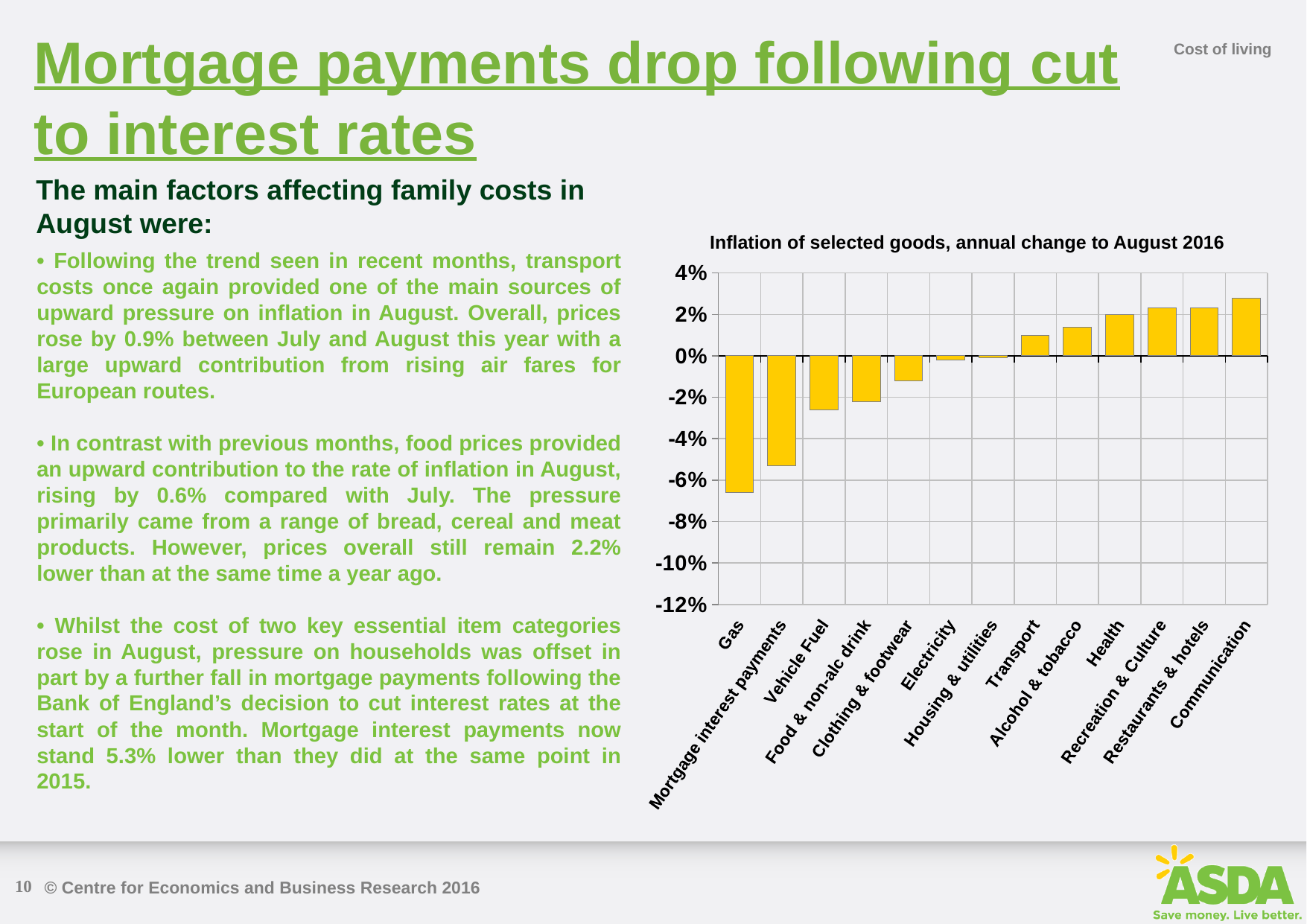
How many categories are plotted in the chart? 13 Is the value for Vehicle Fuel greater or less than -2%? less What kind of chart is shown on the slide? bar chart Which category has the highest value in the chart? Communication Is the value for Alcohol & tobacco greater or less than 2%? less Which category has the lowest value in the chart? Gas Is the value for Gas greater or less than -6%? less Do the values rise or fall moving from left to right along the x axis? rise What is the title of the chart? Inflation of selected goods, annual change to August 2016 Which has the larger value, Gas or Mortgage interest payments? Mortgage interest payments